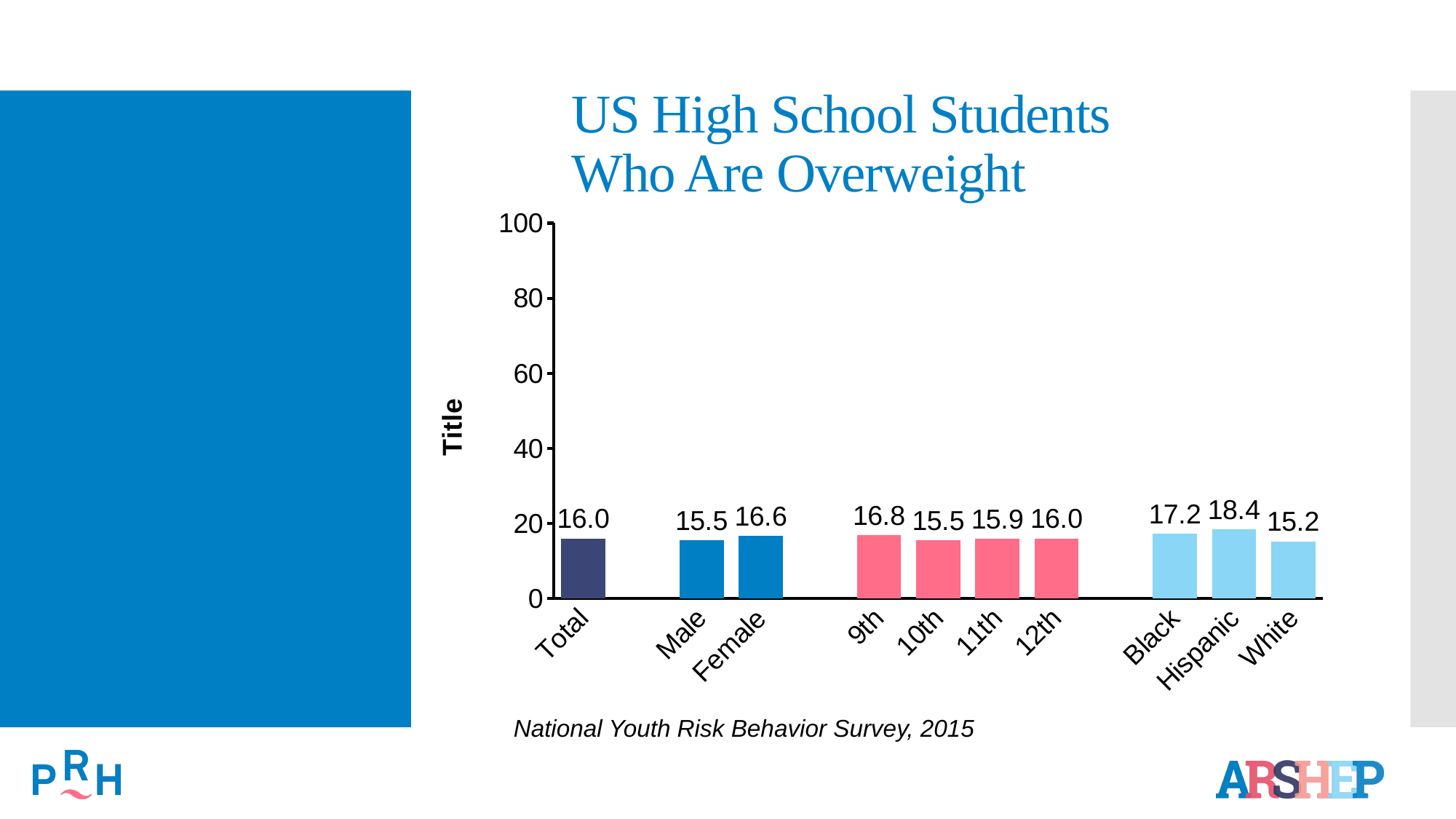
Which category has the lowest value? White What is the title of the chart? US High School Students Who Are Overweight How many categories are shown on the x axis? 10 What is the difference between the values for Female and Male students? 1.1 Is the value for Total greater or less than 20? less What is the difference between the values for Hispanic and White students? 3.2 What is the value for Female students? 16.6 What is the value for Hispanic students? 18.4 What kind of chart is shown on the slide? bar chart Which is larger, the value for Black students or the value for White students? Black What is the value for 9th grade students? 16.8 Which category has the highest value? Hispanic